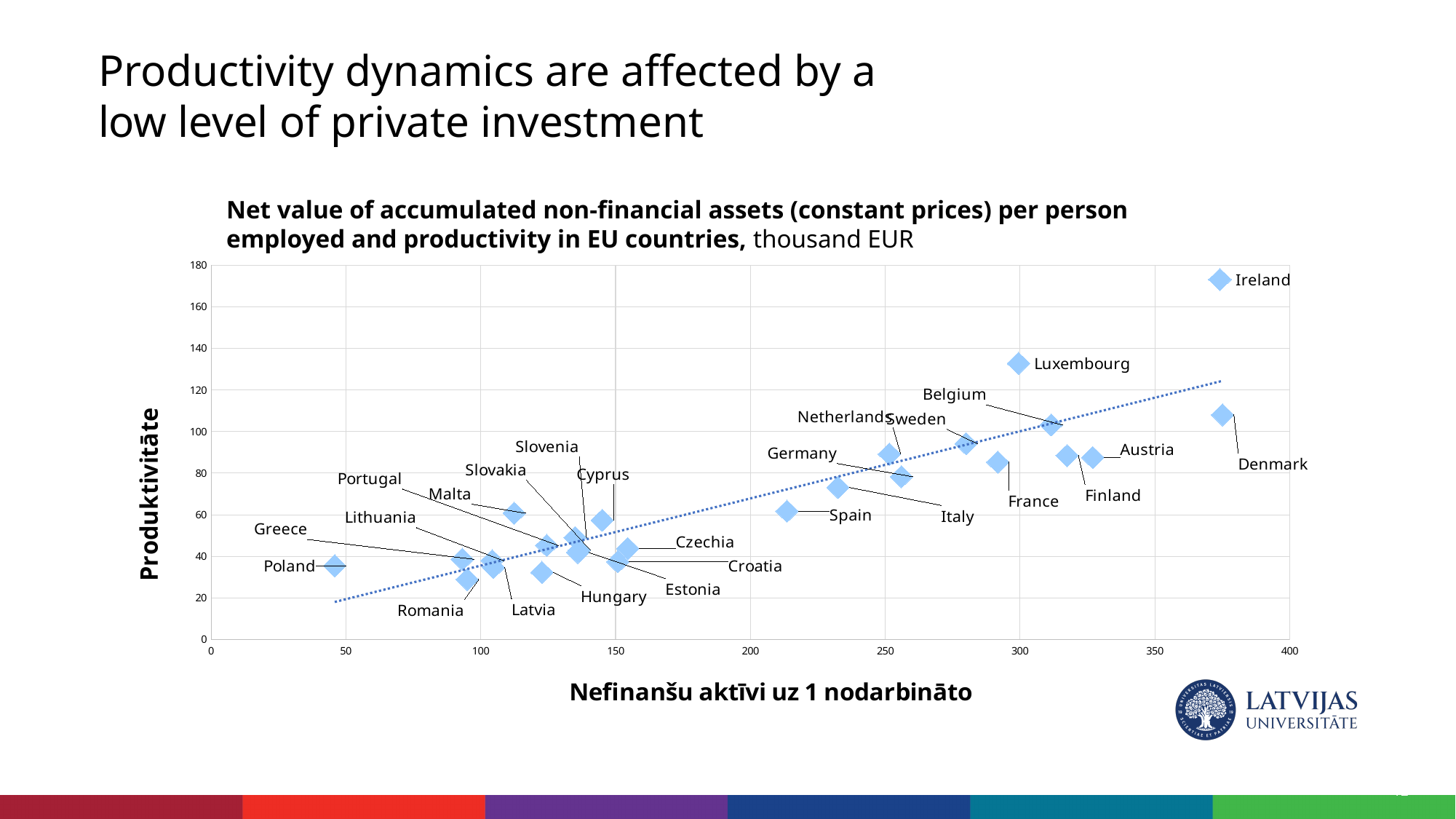
Which has the higher productivity value, Malta or Romania? Malta How many countries are plotted on the chart? 26 Which country has the lowest productivity value on the chart? Romania What kind of chart is shown on the slide? scatter chart Is the productivity value for Luxembourg greater or less than 120? greater Is the productivity value for Poland greater or less than 60? less Which country has the highest productivity value on the chart? Ireland Is the productivity value for Ireland greater or less than 160? greater Which has the higher productivity value, Luxembourg or Belgium? Luxembourg Does the dotted trend line rise or fall as non-financial assets per person employed increase? rises Which country has the lowest value of non-financial assets per person employed (furthest left on the x axis)? Poland